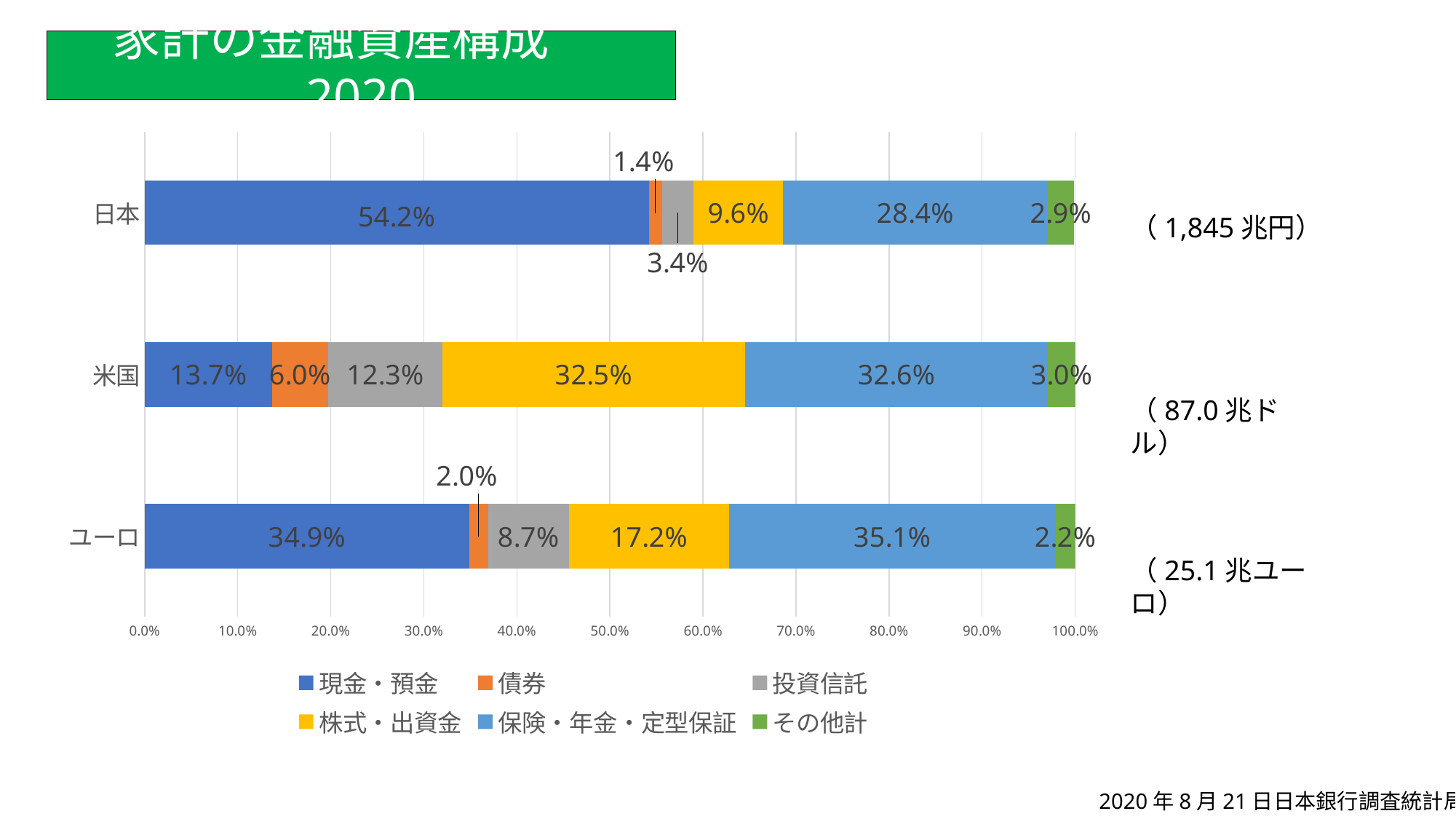
How many categories are shown on the y axis? 3 What is the difference between the 現金・預金 values for 日本 and 米国? 40.5% What is the value for 現金・預金 for 日本? 54.2% What kind of chart is shown on the slide? Stacked bar chart Which category has the highest value for 現金・預金? 日本 Which is larger, the 投資信託 value for 米国 or for ユーロ? 米国 How many series does the legend list? 6 What is the value for 債券 for 日本? 1.4% Which colour represents 株式・出資金 in the chart? Yellow What is the value for 保険・年金・定型保証 for ユーロ? 35.1% Which category has the lowest value for 株式・出資金? 日本 What is the value for 株式・出資金 for 米国? 32.5%